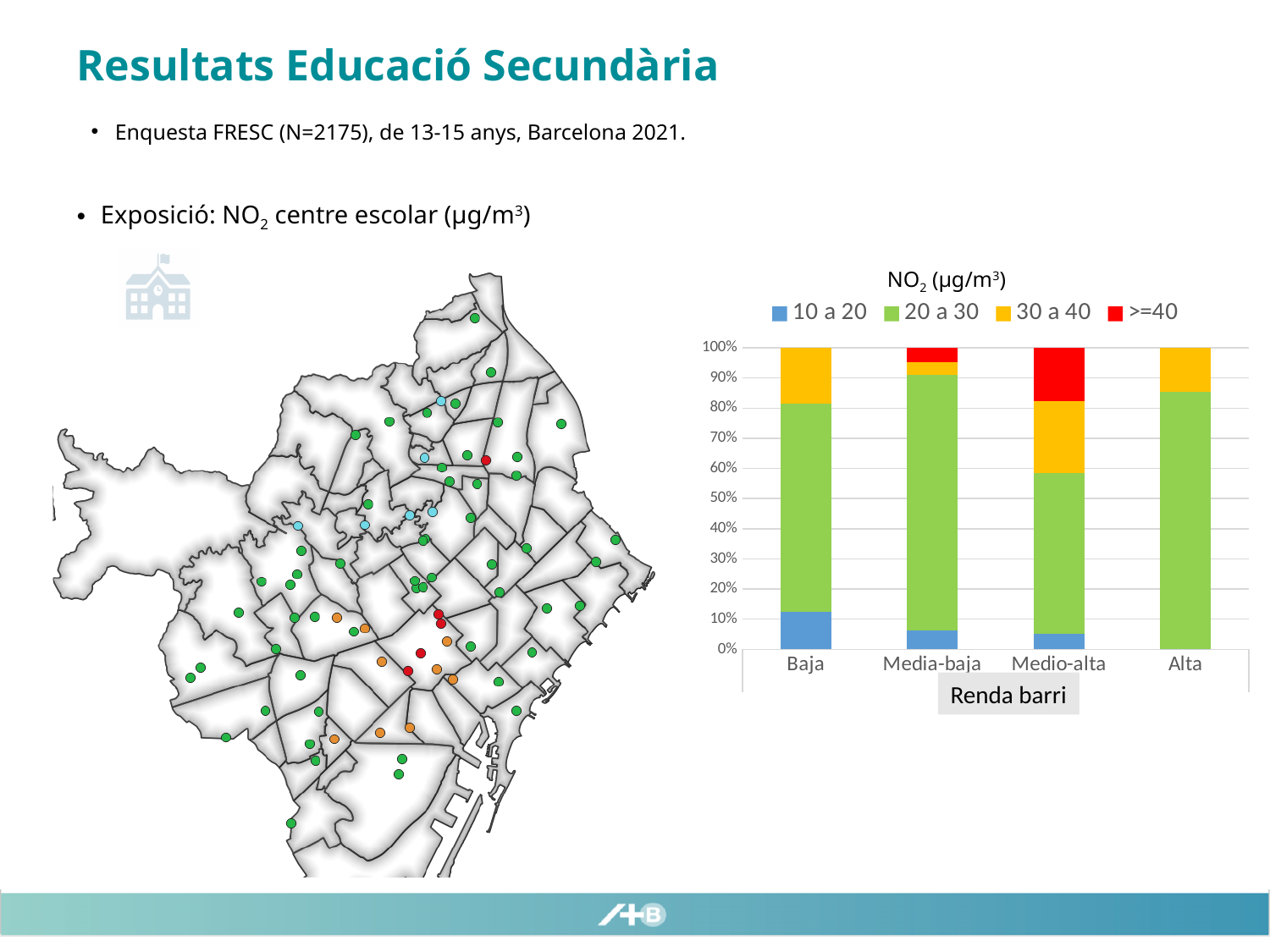
In the bar chart, is the '20 a 30' segment for Alta greater or less than 80%? greater What is the x-axis title of the bar chart? Renda barri In the bar chart, is the '>=40' segment larger for Medio-alta or for Media-baja? Medio-alta How many categories are shown on the x axis of the bar chart? 4 In the bar chart, which category has the largest '>=40' (red) segment? Medio-alta How many series does the legend of the bar chart list? 4 Which legend entry of the bar chart is shown in red? >=40 In the bar chart, is the '10 a 20' segment for Baja greater or less than 10%? greater In the bar chart, which category has the smallest '20 a 30' (green) segment? Medio-alta What kind of chart is shown on the right of the slide? stacked bar chart In the bar chart, which category has the largest '10 a 20' (blue) segment? Baja In the bar chart, is the '30 a 40' segment larger for Baja or for Media-baja? Baja